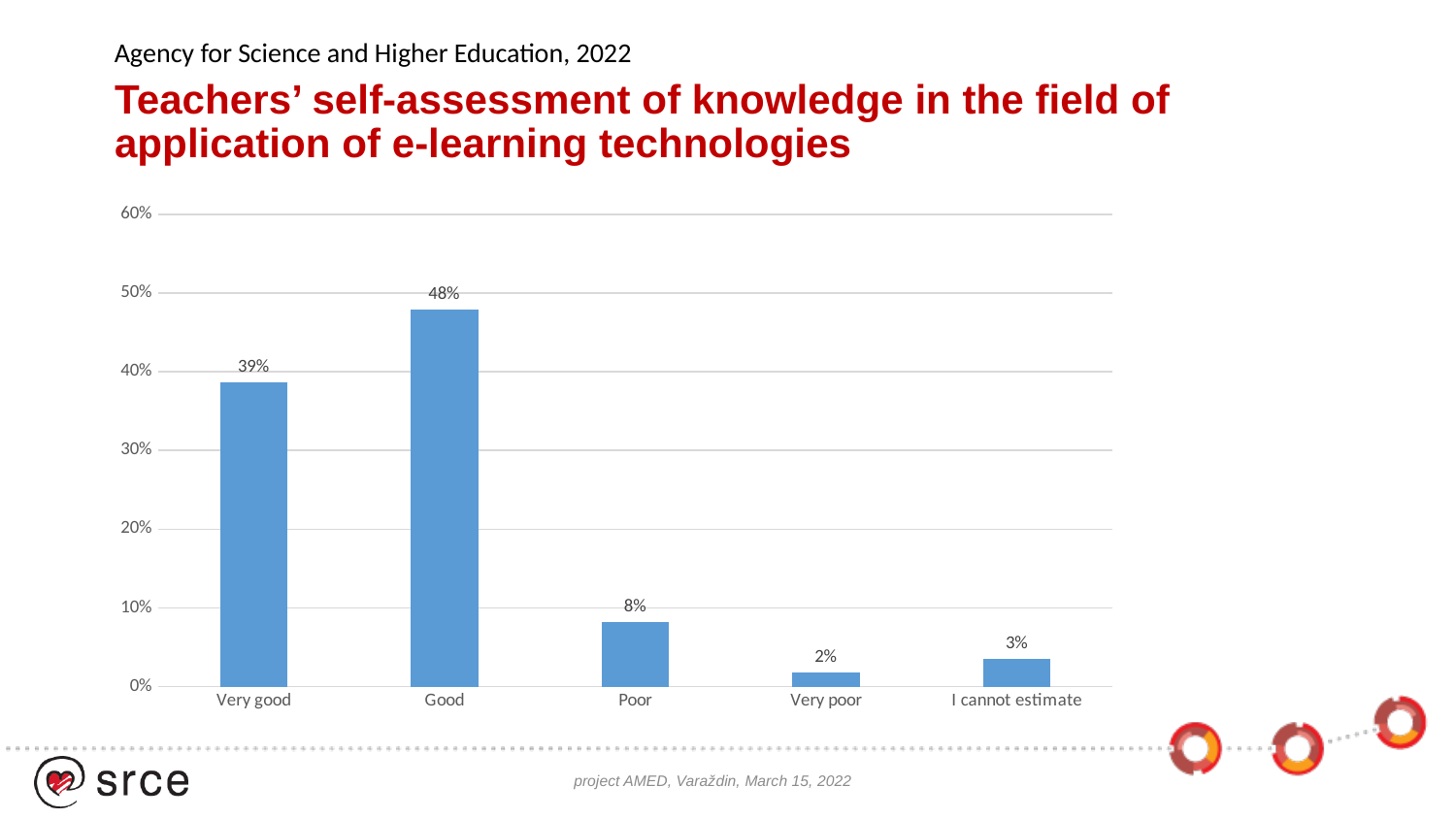
Is the value for Very good greater or less than 40%? less What is the difference between the Good and Very good values? 9% Which category has the highest value? Good What is the title of the chart on the slide? Teachers' self-assessment of knowledge in the field of application of e-learning technologies What is the value for the Very good category? 39% How many categories are shown on the x axis? 5 What is the difference between the Poor and Very poor values? 6% What percentage of teachers rated their knowledge as Good? 48% Which category has the lowest value? Very poor What kind of chart is shown on the slide? bar chart Which is larger, the value for Poor or the value for I cannot estimate? Poor What percentage of teachers answered I cannot estimate? 3%